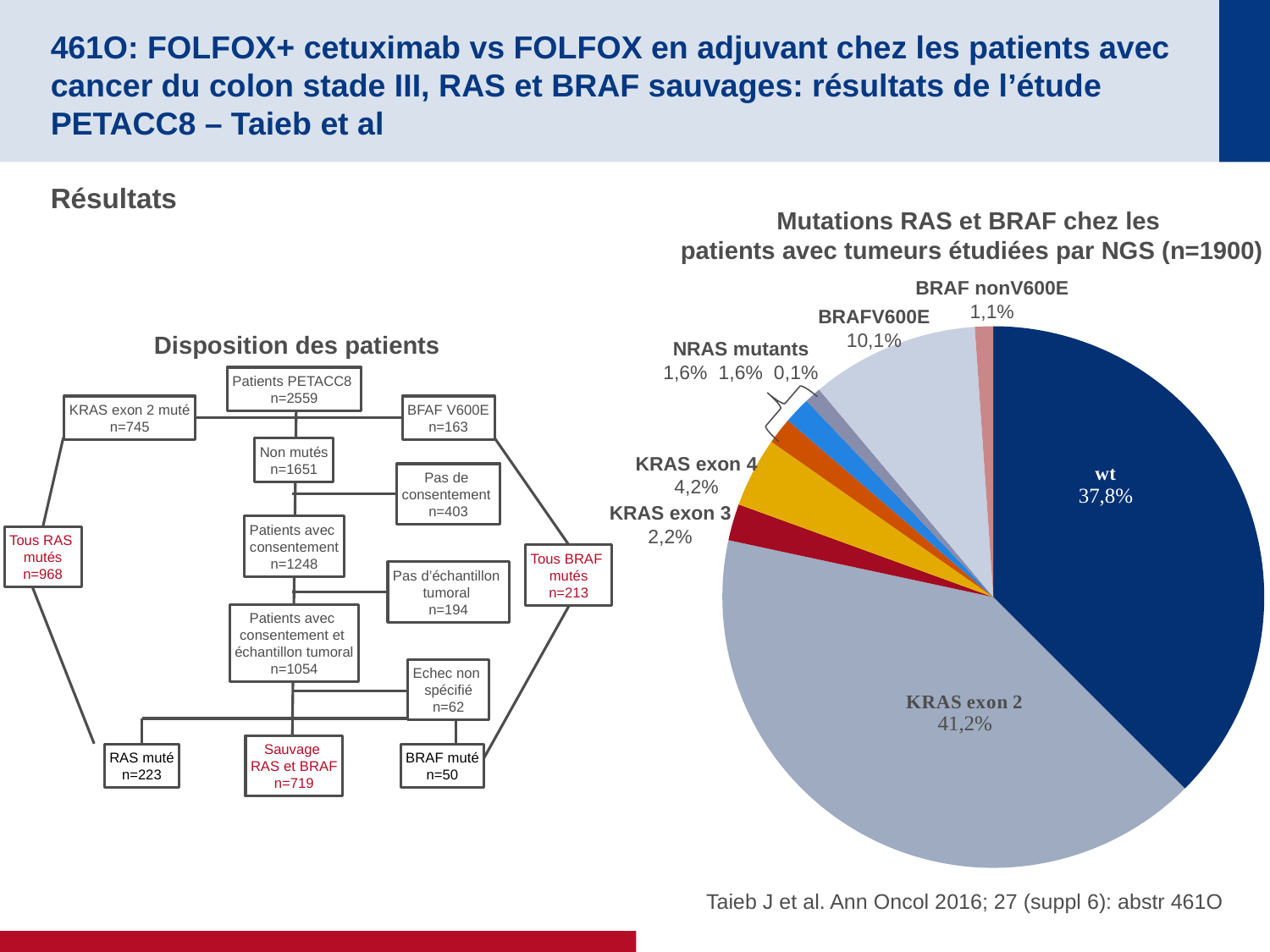
What type of chart is shown on the right side of the slide? Pie chart In the pie chart, what percentage is shown for KRAS exon 3? 2,2% In the pie chart, which slice is larger: wt or KRAS exon 2? KRAS exon 2 According to the pie chart title, how many patients had tumours studied by NGS? n=1900 In the pie chart, what percentage is shown for KRAS exon 4? 4,2% In the pie chart, what percentage is shown for KRAS exon 2? 41,2% In the pie chart, what percentage is shown for BRAFV600E? 10,1% In the pie chart, what is the difference between the KRAS exon 4 share and the KRAS exon 3 share? 2,0% In the pie chart, which category has the largest slice? KRAS exon 2 In the pie chart, what is the difference between the KRAS exon 2 share and the wt share? 3,4% In the pie chart, what share is labelled for the wt slice? 37,8% In the pie chart, what percentage is shown for BRAF nonV600E? 1,1%